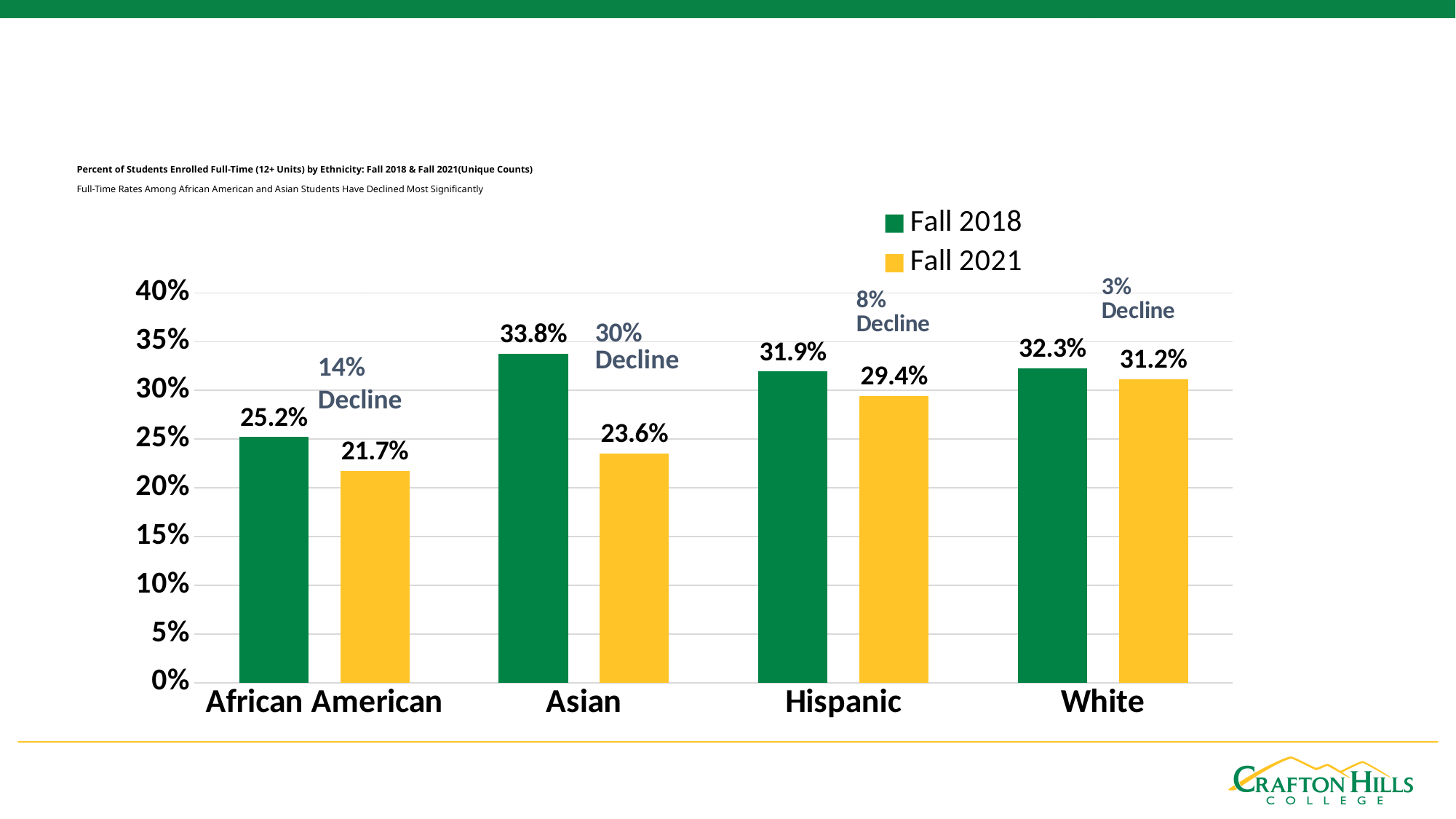
How many series does the legend list? 2 Which ethnicity had the lowest Fall 2021 full-time enrollment percentage? African American Which ethnicity had the highest Fall 2018 full-time enrollment percentage? Asian What kind of chart is shown on the slide? bar chart Which is larger for White students: the Fall 2018 value or the Fall 2021 value? Fall 2018 What was the Fall 2018 full-time enrollment percentage for African American students? 25.2% Is the Fall 2021 value for African American students greater or less than 25%? less What was the Fall 2021 full-time enrollment percentage for Hispanic students? 29.4% What is the difference between the Fall 2018 and Fall 2021 values for Asian students? 10.2% What was the Fall 2021 full-time enrollment percentage for Asian students? 23.6% How many ethnicity categories are shown on the x axis? 4 What percentage decline is annotated for Hispanic students? 8% Decline